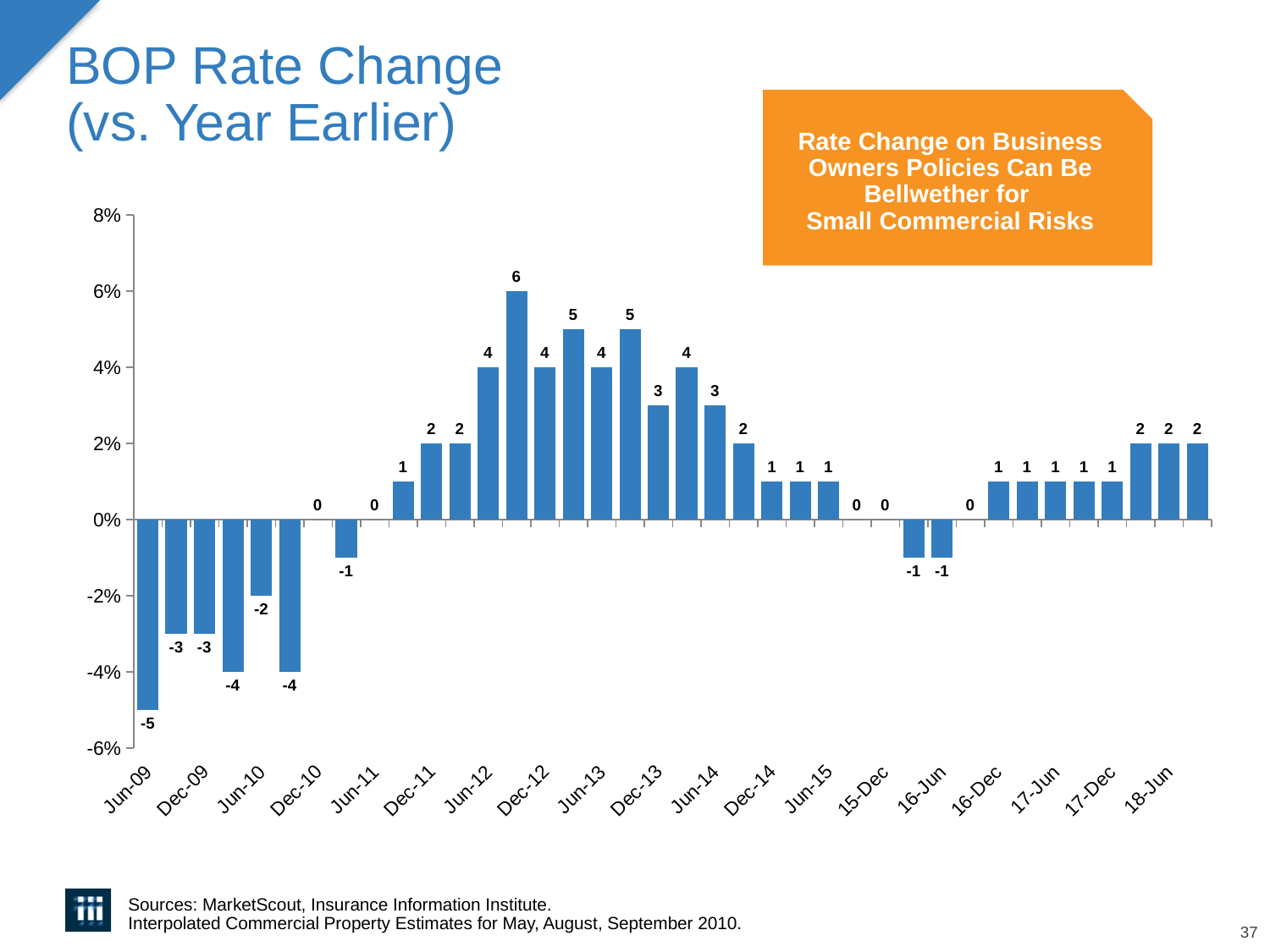
What is the BOP rate change for Jun-09? -5 What is the lowest BOP rate change value shown on the chart? -5 What is the BOP rate change for Dec-09? -3 What is the BOP rate change for Dec-11? 2 Which is larger, the BOP rate change for Jun-09 or for Jun-10? Jun-10 What is the BOP rate change for Jun-10? -2 Do the BOP rate change values generally rise or fall from Jun-09 to Dec-12? rise What is the difference between the highest value (6) and the lowest value (-5) on the chart? 11 What is the highest BOP rate change value shown on the chart? 6 What is the BOP rate change for 18-Jun, the last bar on the chart? 2 What type of chart is shown on the slide? bar chart What is the title of the chart? BOP Rate Change (vs. Year Earlier)